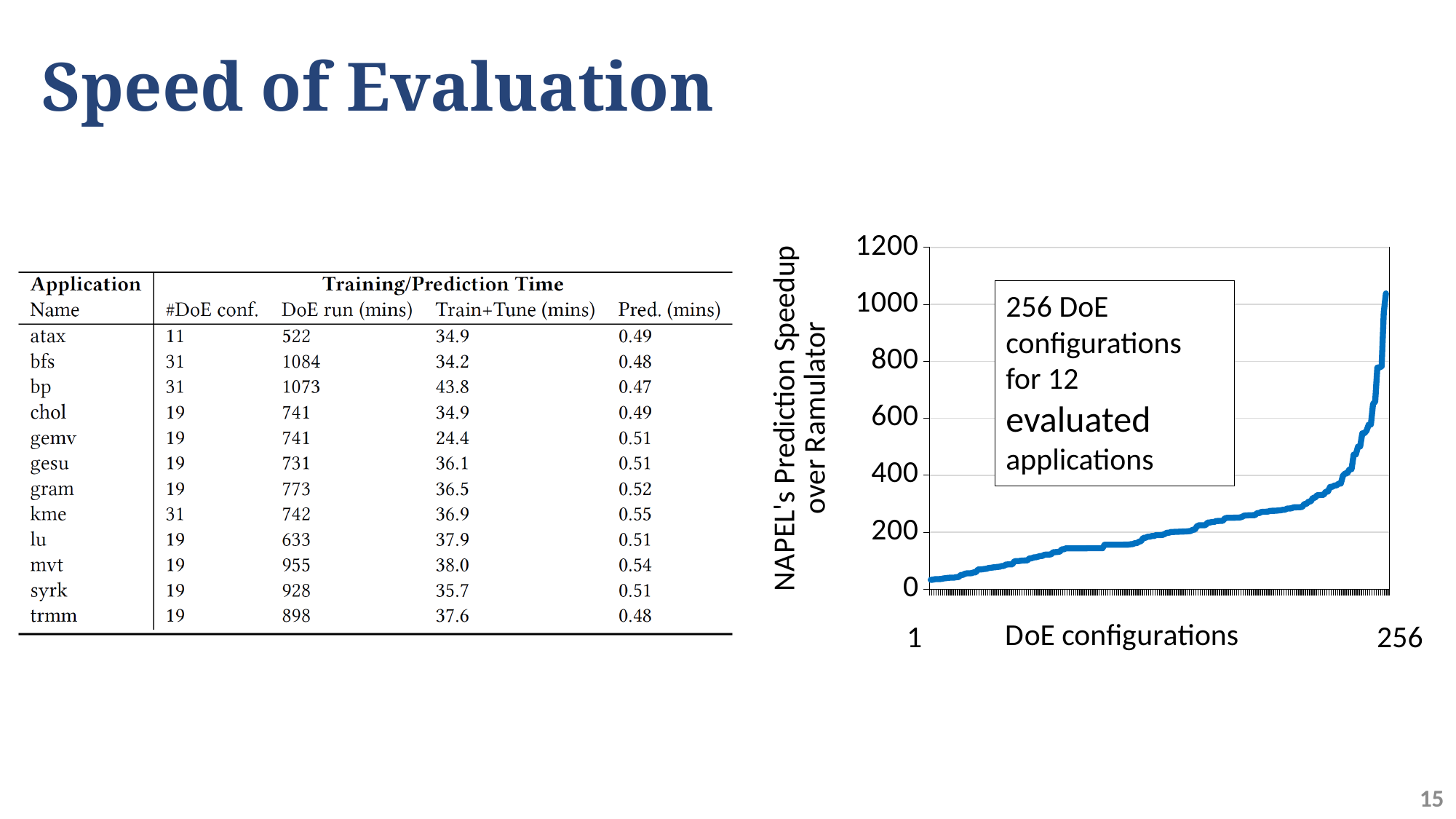
How many DoE configurations are plotted along the x axis of the chart? 256 Do the values in the chart rise or fall as the DoE configurations go from 1 to 256? rise Is the highest speedup value in the chart greater or less than 1200? less Which DoE configuration has the lowest prediction speedup in the chart? 1 How many data series are plotted in the chart on the right? 1 What kind of chart is shown on the right of the slide? line chart Is the speedup value at DoE configuration 1 greater or less than 200? less Is the speedup value at DoE configuration 256 greater or less than 800? greater Which DoE configuration has the highest prediction speedup in the chart? 256 What is the x-axis label of the chart on the right? DoE configurations What is the y-axis label of the chart on the right? NAPEL's Prediction Speedup over Ramulator What is the maximum value shown on the y axis of the chart? 1200